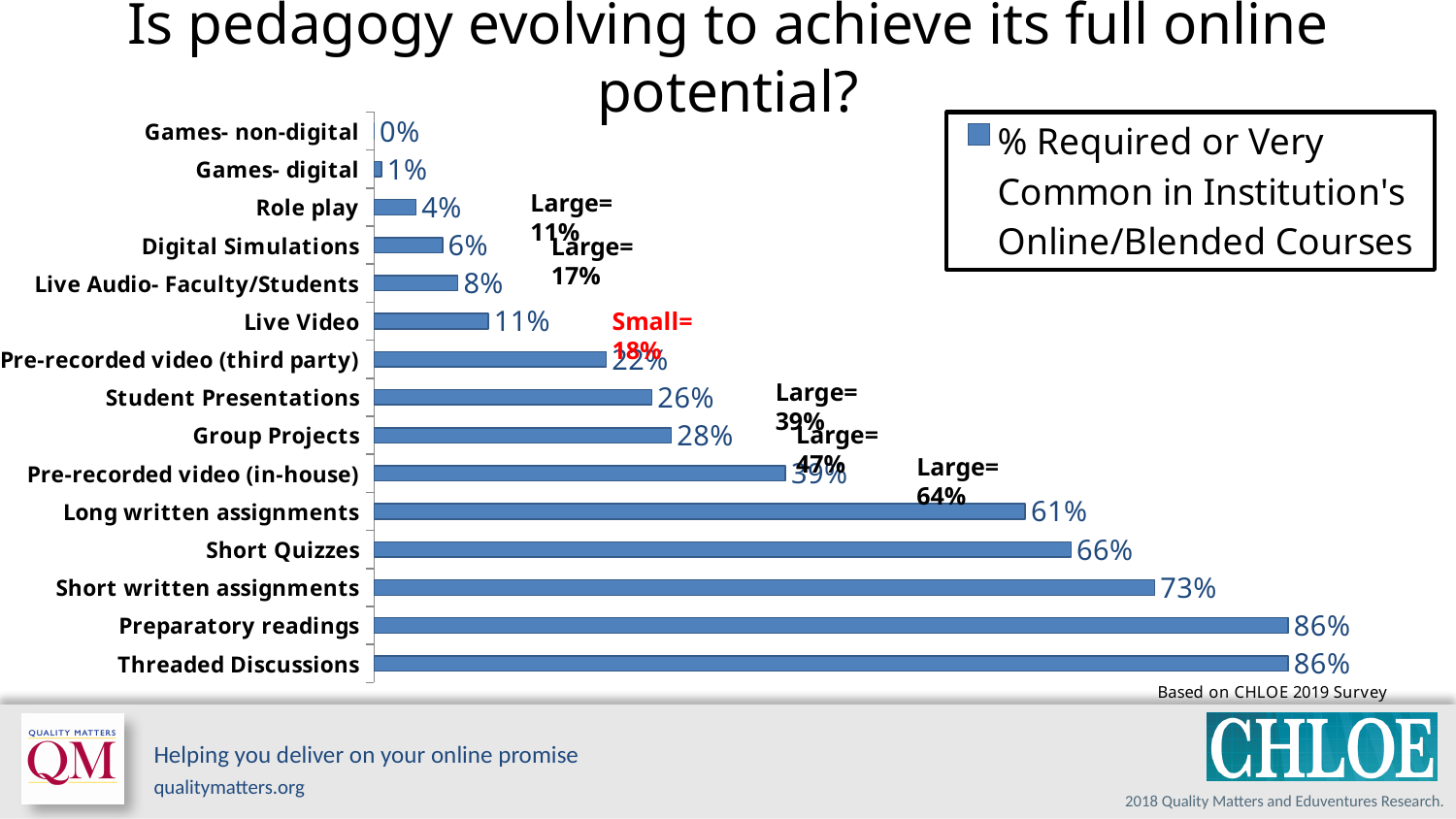
What is the value for Threaded Discussions? 86% What is the value for Long written assignments? 61% Which category has the lowest value? Games- non-digital What is the legend entry for the series in the chart? % Required or Very Common in Institution's Online/Blended Courses What type of chart is shown on the slide? bar chart What is the difference between Short written assignments and Short Quizzes? 7% Which is larger, Student Presentations or Digital Simulations? Student Presentations What is the value for Group Projects? 28% What is the value for Live Video? 11% What is the value for Short Quizzes? 66% How many categories are shown in the chart? 15 How many series does the legend list? 1